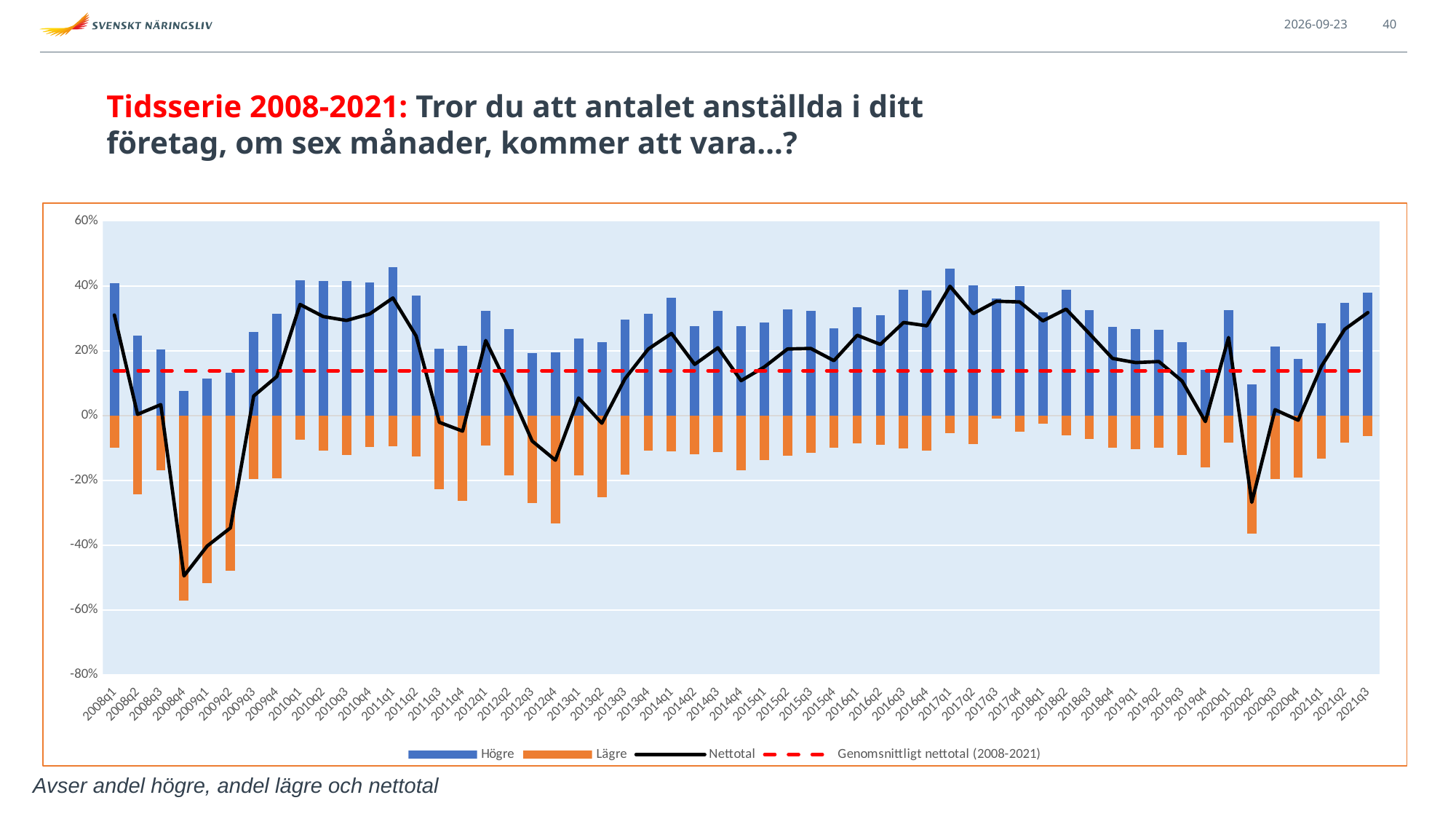
Is the Nettotal value for 2020q2 greater or less than -20%? less What kind of chart is shown on the slide? Bar chart with line series In which quarter does the Lägre bar reach its lowest (most negative) value? 2008q4 Is the Högre value for 2008q4 greater or less than 20%? less In which quarter does the Nettotal line reach its highest point? 2017q1 What does the red dashed line in the chart represent? Genomsnittligt nettotal (2008-2021) How many quarters (categories) are shown on the x axis? 55 How many series does the chart legend list? 4 Is the Nettotal value for 2021q3 greater or less than 20%? greater Does the Nettotal line rise or fall from 2020q2 to 2021q3? rise In which quarter does the Nettotal line reach its lowest point? 2008q4 Which quarter has the larger Högre value, 2010q1 or 2008q4? 2010q1